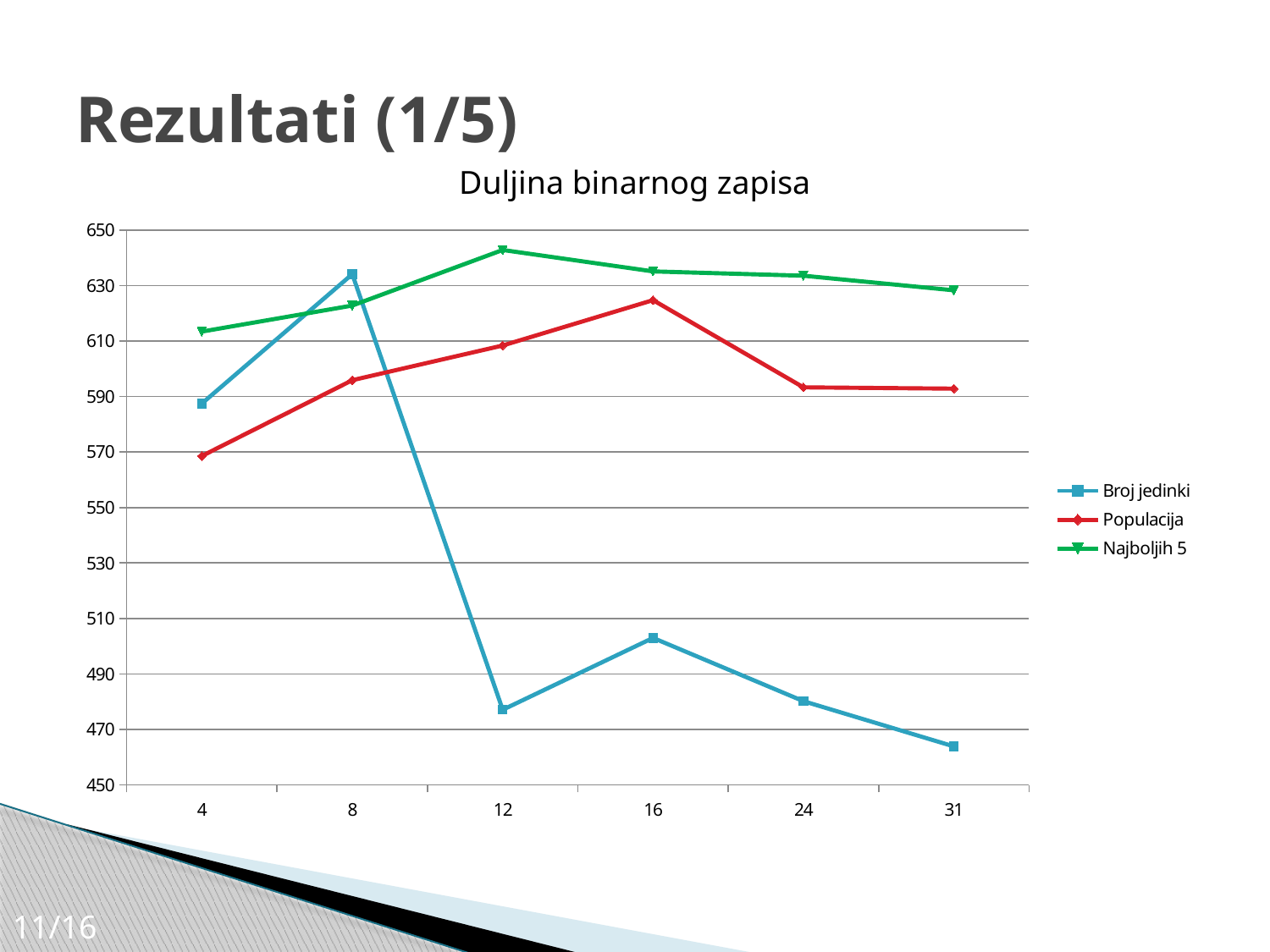
At x-axis category 4, which series has the larger value, Najboljih 5 or Populacija? Najboljih 5 How many x-axis categories are plotted in the chart? 6 At which x-axis category does the Populacija series reach its highest value? 16 What kind of chart is shown on the slide? line chart What is the title of the chart? Duljina binarnog zapisa How many series does the legend list? 3 Is the value for Broj jedinki at 12 greater or less than 490? less Which series is drawn in green? Najboljih 5 Is the value for Populacija at 16 greater or less than 610? greater At which x-axis category does the Najboljih 5 series reach its highest value? 12 At which x-axis category does the Broj jedinki series reach its lowest value? 31 At which x-axis category does the Broj jedinki series reach its highest value? 8